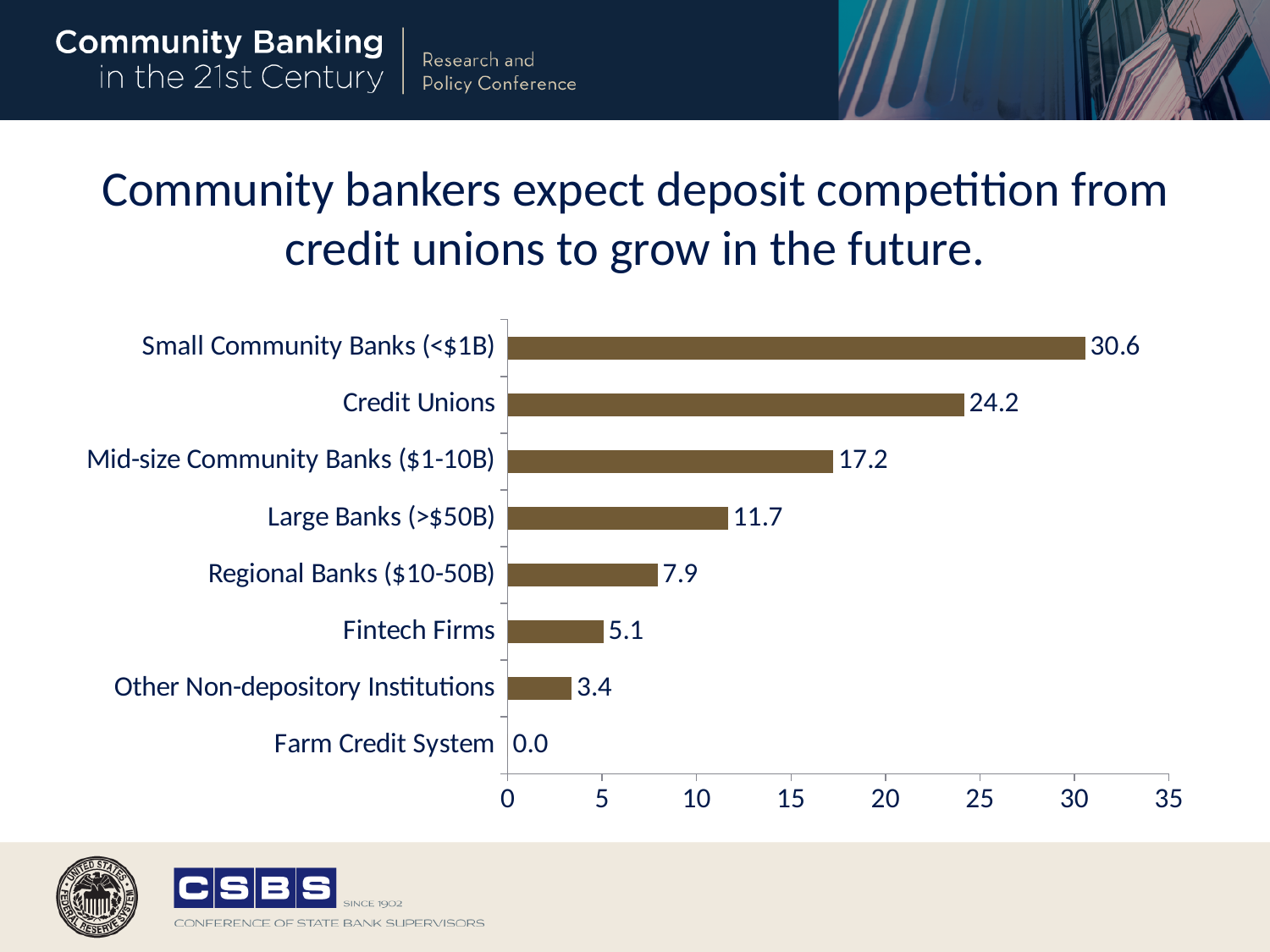
What kind of chart is shown on the slide? bar chart What is the difference between the values for Mid-size Community Banks ($1-10B) and Regional Banks ($10-50B)? 9.3 Which category has the lowest value? Farm Credit System Which category has the highest value? Small Community Banks (<$1B) What is the value for Fintech Firms? 5.1 Is the value for Mid-size Community Banks ($1-10B) greater or less than 15? greater What is the value for Credit Unions? 24.2 How many categories are shown in the chart? 8 What is the difference between the values for Small Community Banks (<$1B) and Credit Unions? 6.4 What is the title of the slide above the chart? Community bankers expect deposit competition from credit unions to grow in the future. What is the value for Large Banks (>$50B)? 11.7 Which is larger, the value for Regional Banks ($10-50B) or the value for Fintech Firms? Regional Banks ($10-50B)